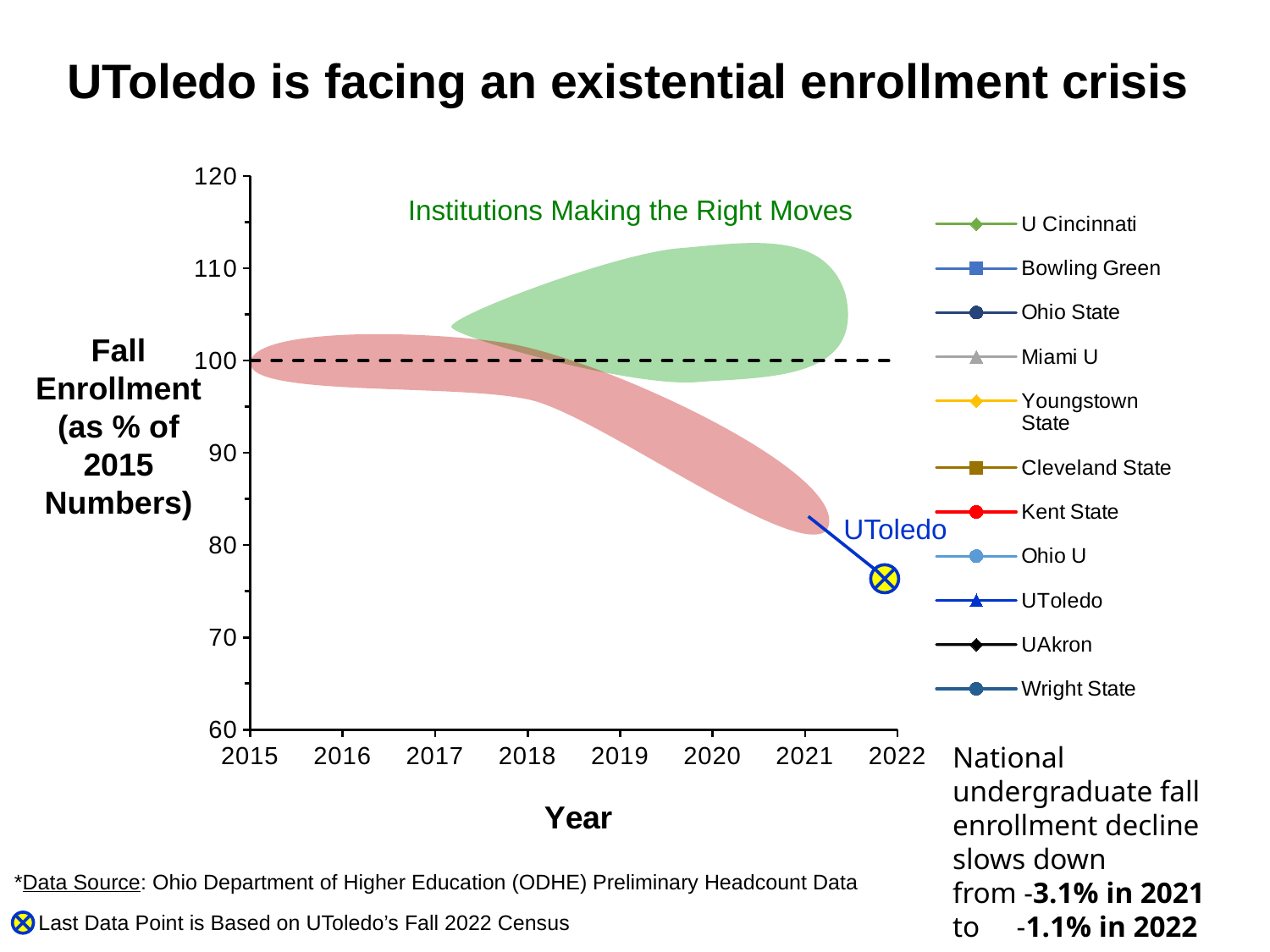
What is the title of the slide containing the chart? UToledo is facing an existential enrollment crisis What is the last series listed in the chart's legend? Wright State Does the UToledo line rise or fall between 2021 and 2022? fall How many series does the chart's legend list? 11 Is the value for UToledo in 2022 greater or less than 80? less How many years are marked along the x axis of the chart? 8 What is the highest value shown on the y axis of the chart? 120 What kind of chart is shown on the slide? line chart Is the value for UToledo in 2022 greater or less than 70? greater